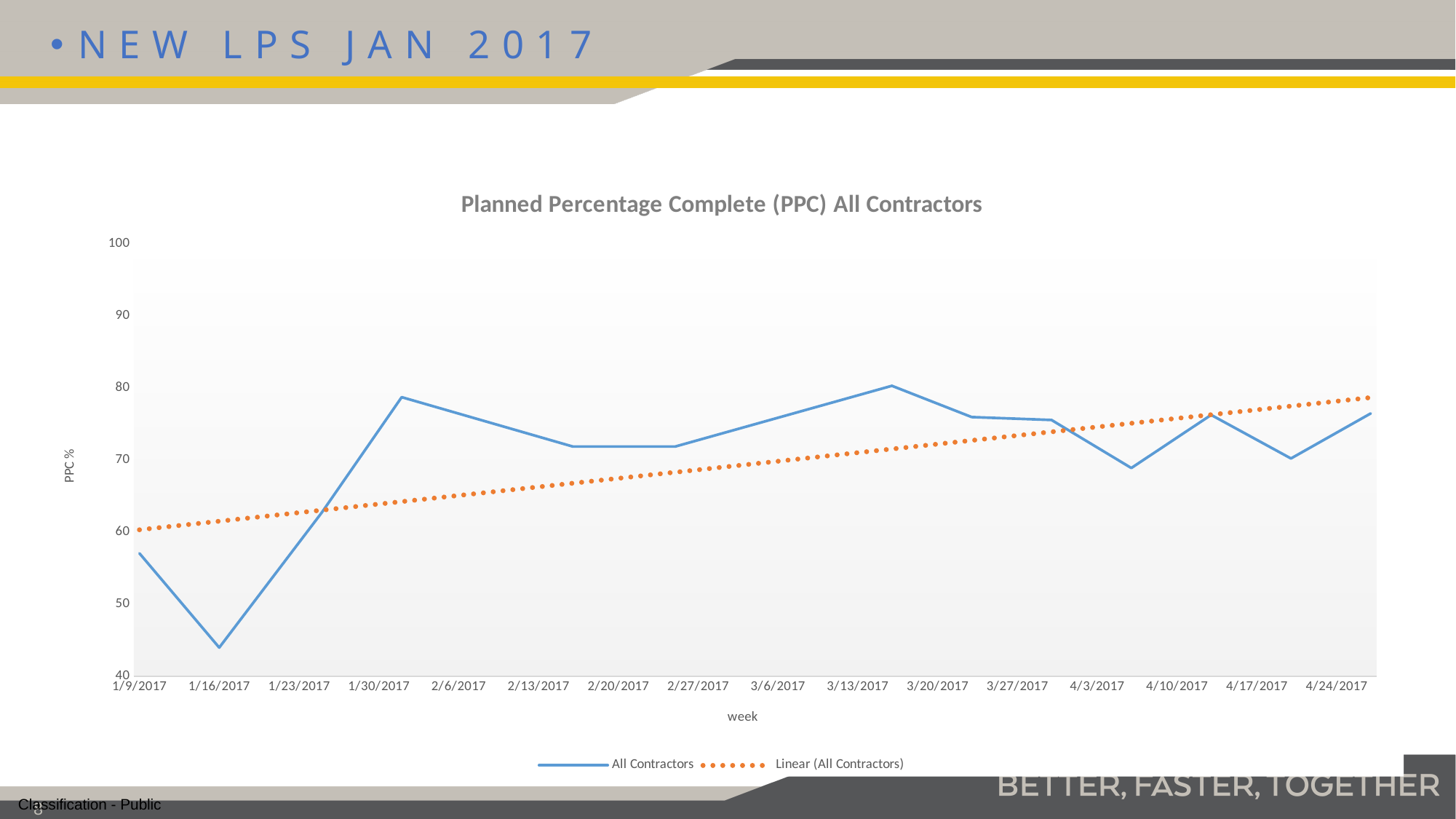
Is the All Contractors value for 1/16/2017 greater or less than 50? less What kind of chart is shown on the slide? line chart How many series does the legend list? 2 Does the Linear (All Contractors) trendline rise or fall from left to right? rise What label is shown on the y axis? PPC % Is the All Contractors value for 1/30/2017 greater or less than 70? greater Which week has the larger All Contractors value, 1/30/2017 or 2/6/2017? 1/30/2017 Which week has the highest PPC value for All Contractors? 3/13/2017 Is the All Contractors value for 1/9/2017 greater or less than 60? less What is the title of the chart? Planned Percentage Complete (PPC) All Contractors Which week has the lowest PPC value for All Contractors? 1/16/2017